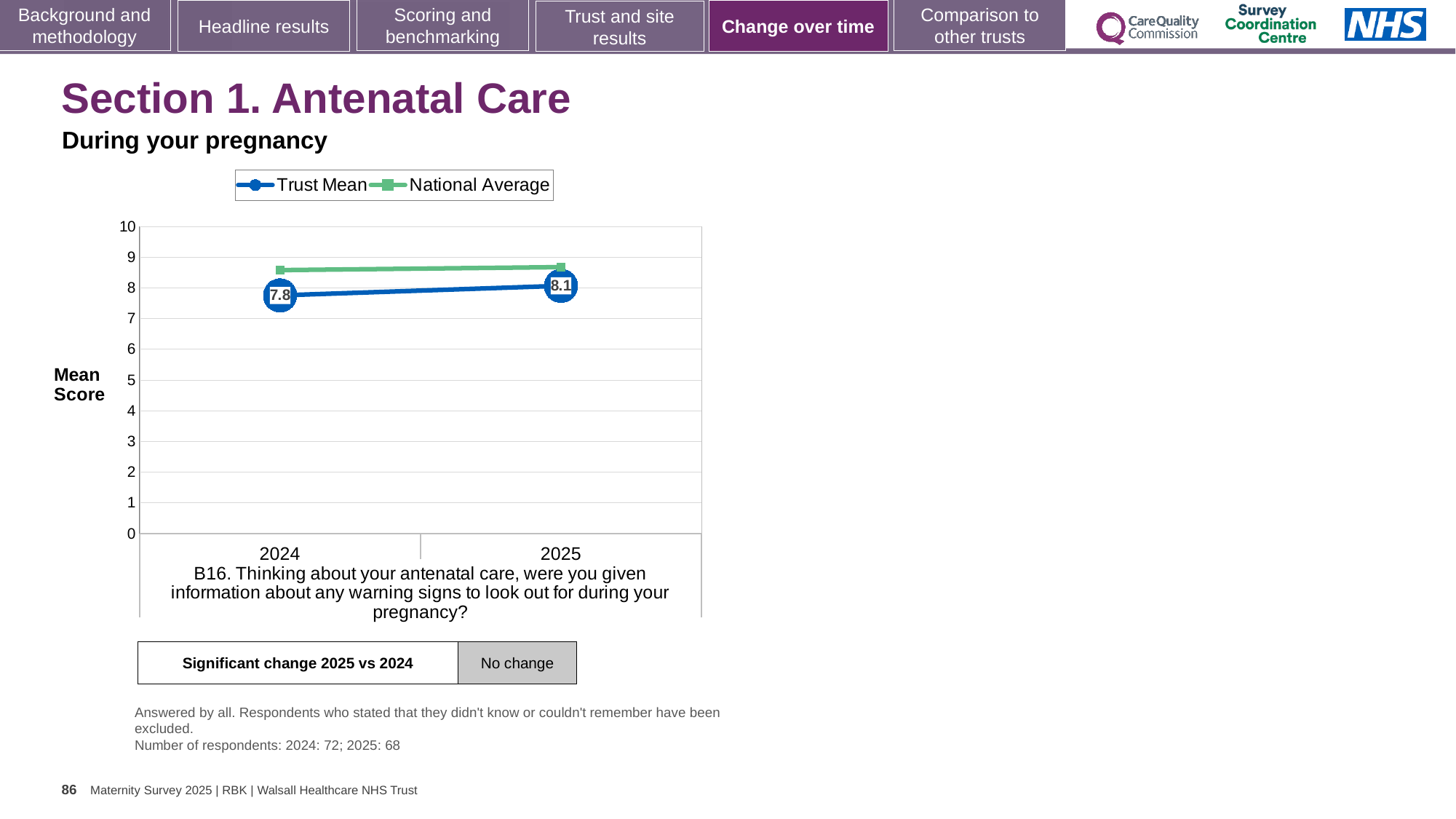
How many years are shown on the x axis of the chart? 2 What is the Trust Mean score for 2024? 7.8 Is the National Average for 2025 greater or less than 9? less Does the Trust Mean rise or fall from 2024 to 2025? rise In 2024, which series has the higher value, Trust Mean or National Average? National Average How many series does the chart legend list? 2 What is the Trust Mean score for 2025? 8.1 In which year is the Trust Mean higher, 2024 or 2025? 2025 Is the National Average for 2024 greater or less than 8? greater What is the label on the y axis of the chart? Mean Score What kind of chart is shown on the slide? line chart By how much did the Trust Mean change from 2024 to 2025? 0.3